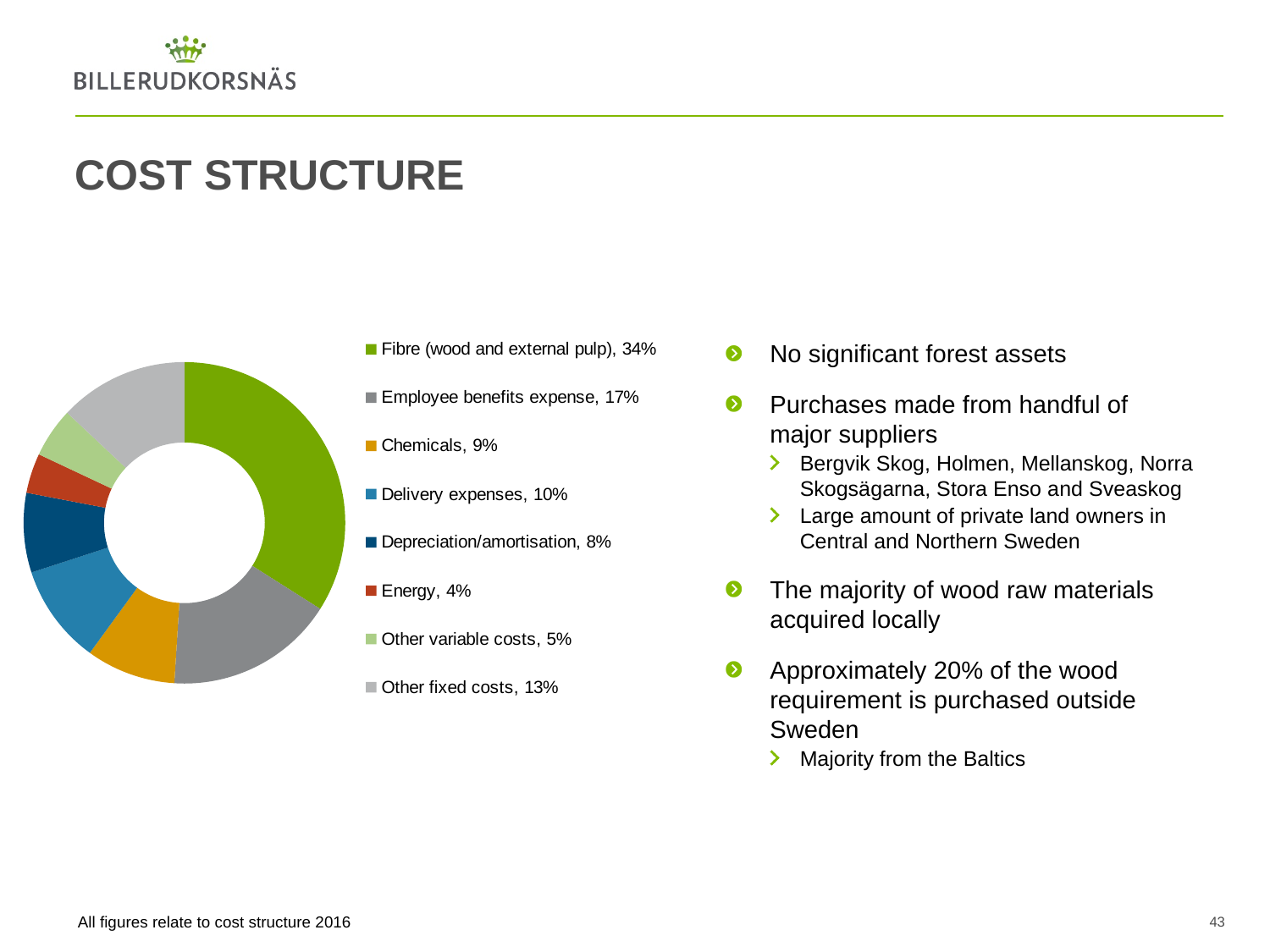
What share of the cost structure is Delivery expenses? 10% How many cost categories are shown in the chart? 8 Which cost category has the smallest share of the cost structure? Energy What is the combined share of Other variable costs and Other fixed costs? 18% What share of the cost structure is Fibre (wood and external pulp)? 34% What share of the cost structure is Energy? 4% Which cost category has the largest share of the cost structure? Fibre (wood and external pulp) Which year do the figures in the chart relate to? 2016 What share of the cost structure is Employee benefits expense? 17% What is the difference in percentage points between Fibre (wood and external pulp) and Employee benefits expense? 17 What kind of chart is used to show the cost structure? Pie chart (doughnut) Which is larger: the share for Chemicals or the share for Depreciation/amortisation? Chemicals